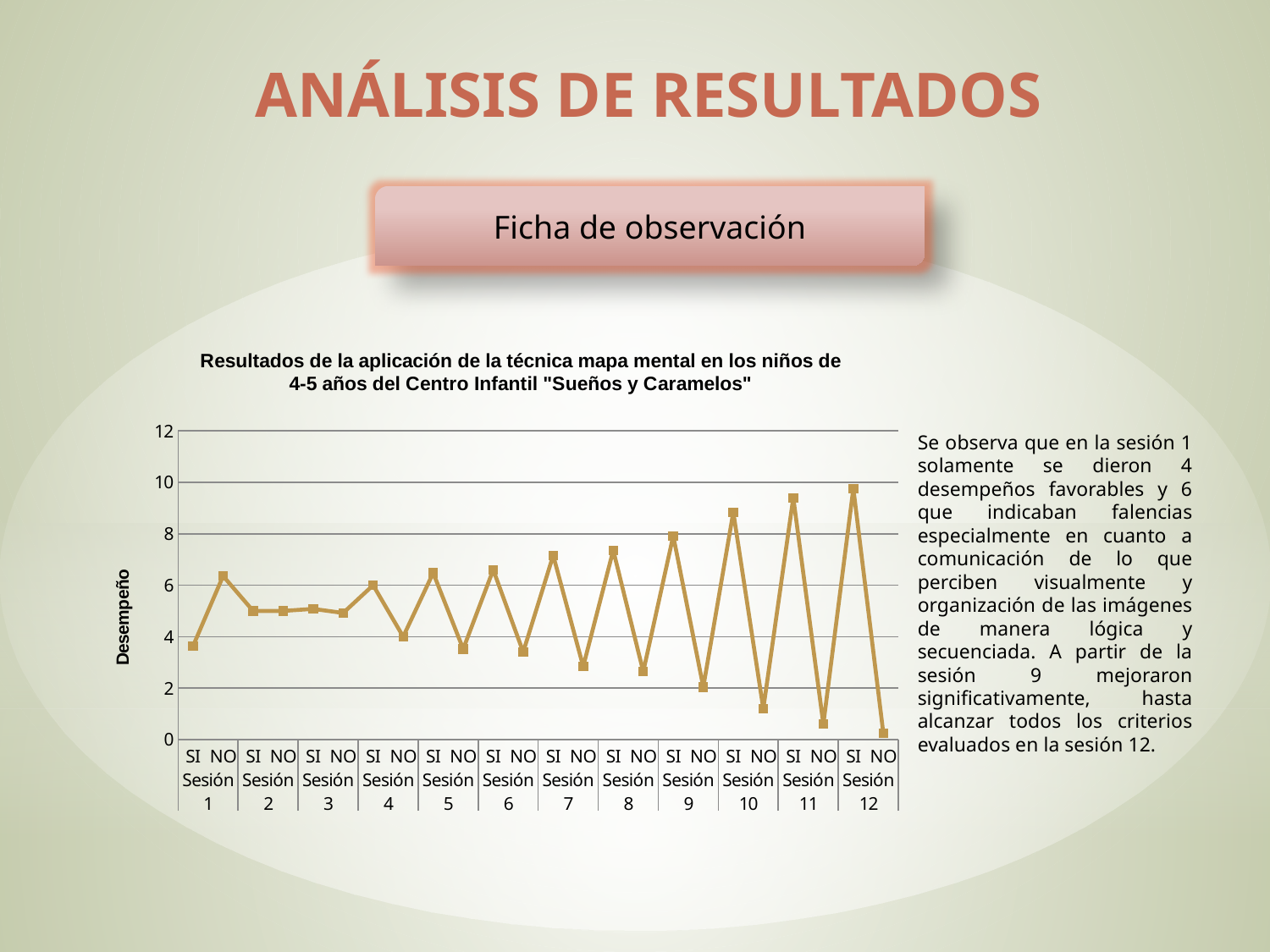
Which session has the highest SI value in the chart? Sesión 12 What kind of chart is shown on the slide? Line chart In Sesión 12, which is larger, the SI value or the NO value? SI Is the NO value for Sesión 1 greater or less than 6? greater Is the NO value for Sesión 8 greater or less than 4? less Is the SI value for Sesión 10 greater or less than 8? greater In Sesión 1, which is larger, the SI value or the NO value? NO Which session has the lowest NO value in the chart? Sesión 12 How many sessions (Sesión) are shown along the x axis of the chart? 12 Do the SI values generally rise or fall from Sesión 1 to Sesión 12? Rise What is the label of the vertical axis of the chart? Desempeño